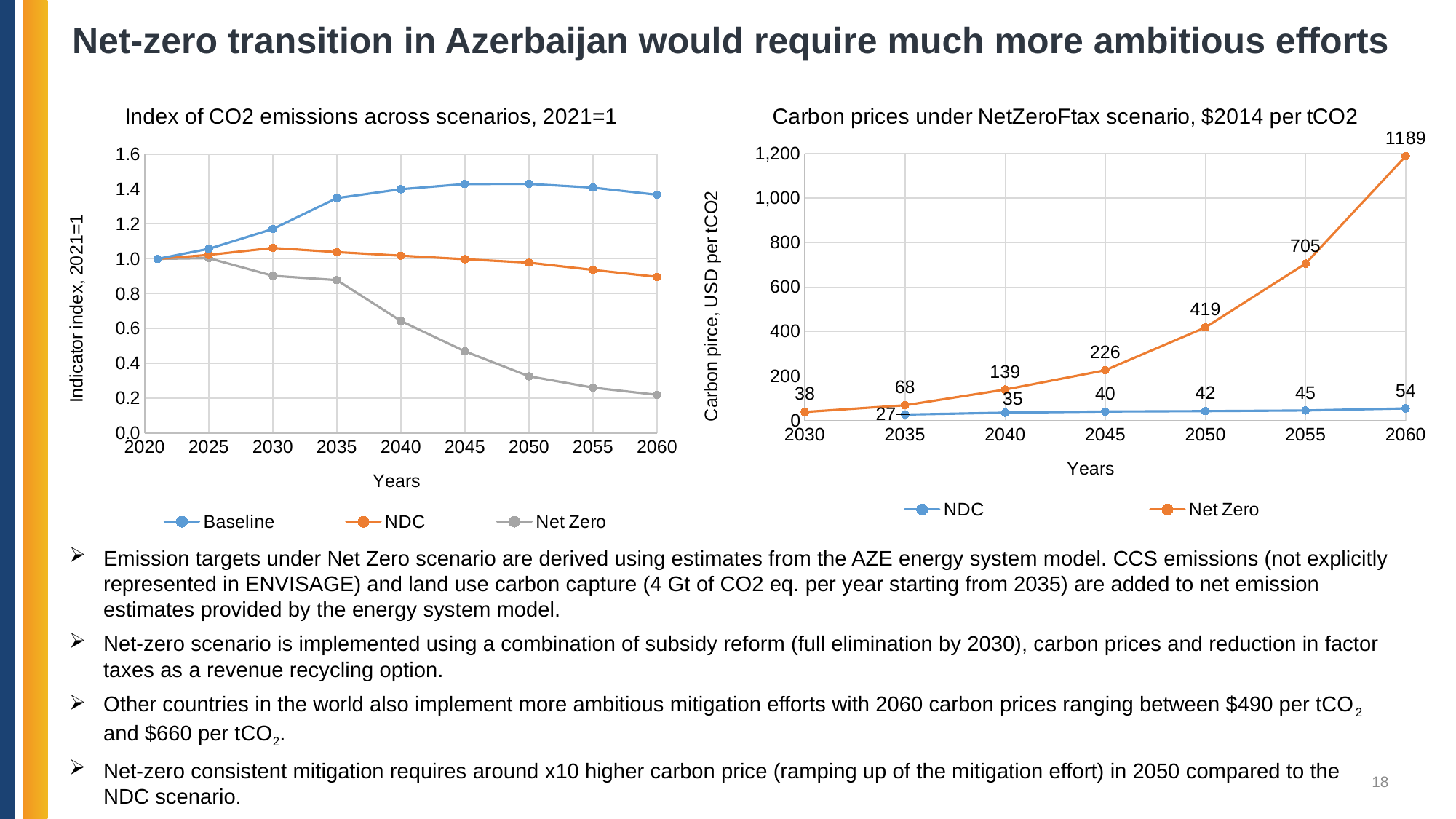
In the chart titled 'Carbon prices under NetZeroFtax scenario, $2014 per tCO2', what is the NDC carbon price in 2050? 42 In the chart titled 'Carbon prices under NetZeroFtax scenario, $2014 per tCO2', what is the Net Zero carbon price in 2060? 1189 In the chart titled 'Index of CO2 emissions across scenarios, 2021=1', how many series does the legend list? 3 In the chart titled 'Index of CO2 emissions across scenarios, 2021=1', is the Baseline value in 2045 greater or less than 1.2? greater In the chart titled 'Index of CO2 emissions across scenarios, 2021=1', is the Net Zero value in 2060 greater or less than 0.4? less In the chart titled 'Index of CO2 emissions across scenarios, 2021=1', which series has the lowest value in 2060? Net Zero What kind of chart is the chart titled 'Index of CO2 emissions across scenarios, 2021=1'? line chart In the chart titled 'Carbon prices under NetZeroFtax scenario, $2014 per tCO2', what is the Net Zero carbon price in 2045? 226 In the chart titled 'Carbon prices under NetZeroFtax scenario, $2014 per tCO2', does the Net Zero carbon price rise or fall from 2030 to 2060? rise In the chart titled 'Carbon prices under NetZeroFtax scenario, $2014 per tCO2', how many series does the legend list? 2 In the chart titled 'Carbon prices under NetZeroFtax scenario, $2014 per tCO2', how many years are plotted on the x axis? 7 In the chart titled 'Carbon prices under NetZeroFtax scenario, $2014 per tCO2', what is the difference between the Net Zero and NDC carbon prices in 2050? 377